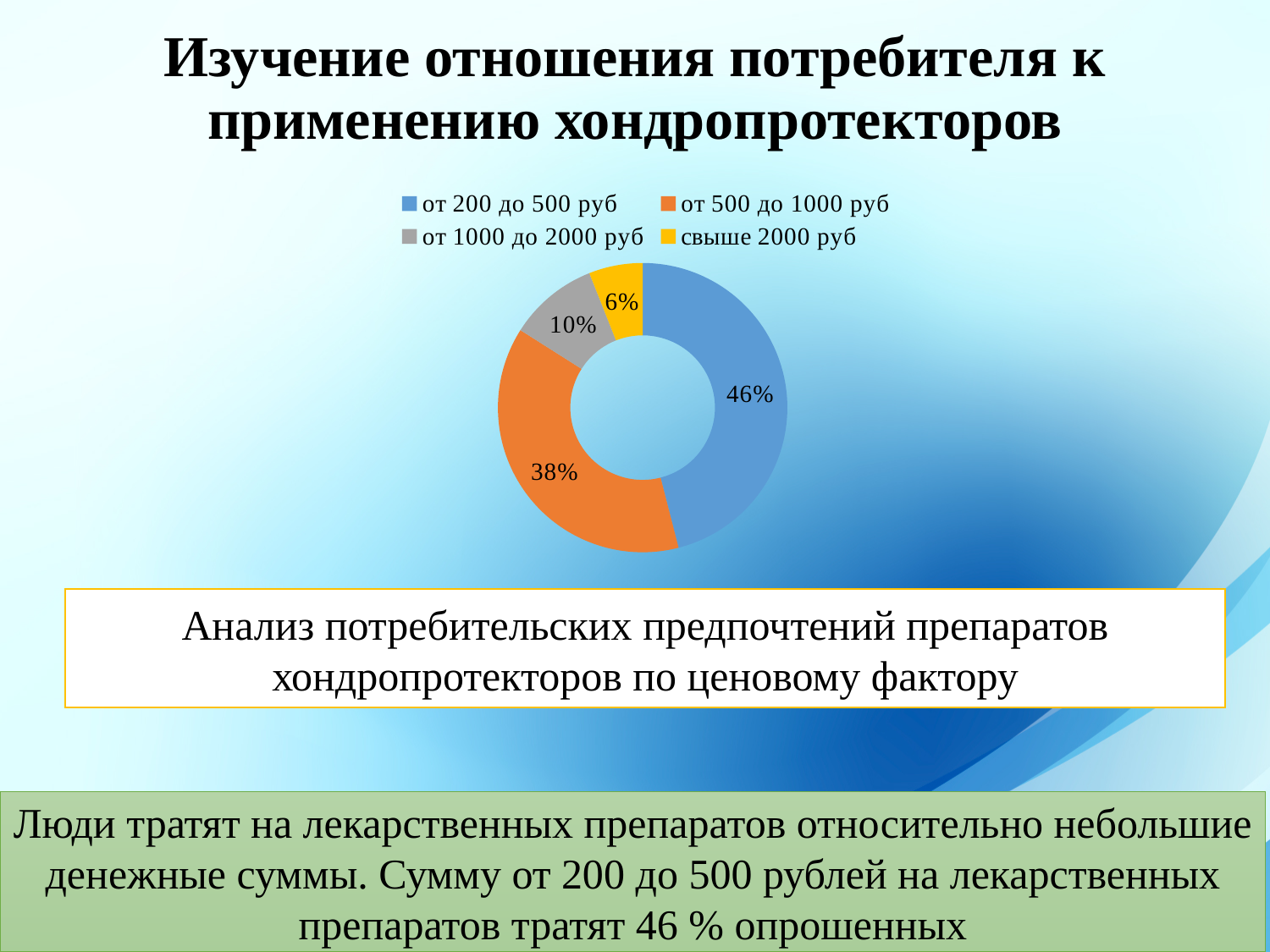
What share of the doughnut chart is labelled "от 1000 до 2000 руб"? 10% What is the difference in percentage points between the "от 200 до 500 руб" and "от 500 до 1000 руб" slices? 8% What share of the doughnut chart is labelled "от 200 до 500 руб"? 46% What is the combined share of the "от 1000 до 2000 руб" and "свыше 2000 руб" slices? 16% How many categories are shown in the doughnut chart? 4 Which category has the largest share in the doughnut chart? от 200 до 500 руб What colour is the slice for "от 500 до 1000 руб"? Orange What share of the doughnut chart is labelled "свыше 2000 руб"? 6% Which category has the smallest share in the doughnut chart? свыше 2000 руб What kind of chart is shown on the slide? Doughnut (pie) chart What share of the doughnut chart is labelled "от 500 до 1000 руб"? 38% Which slice is larger: "от 1000 до 2000 руб" or "свыше 2000 руб"? от 1000 до 2000 руб